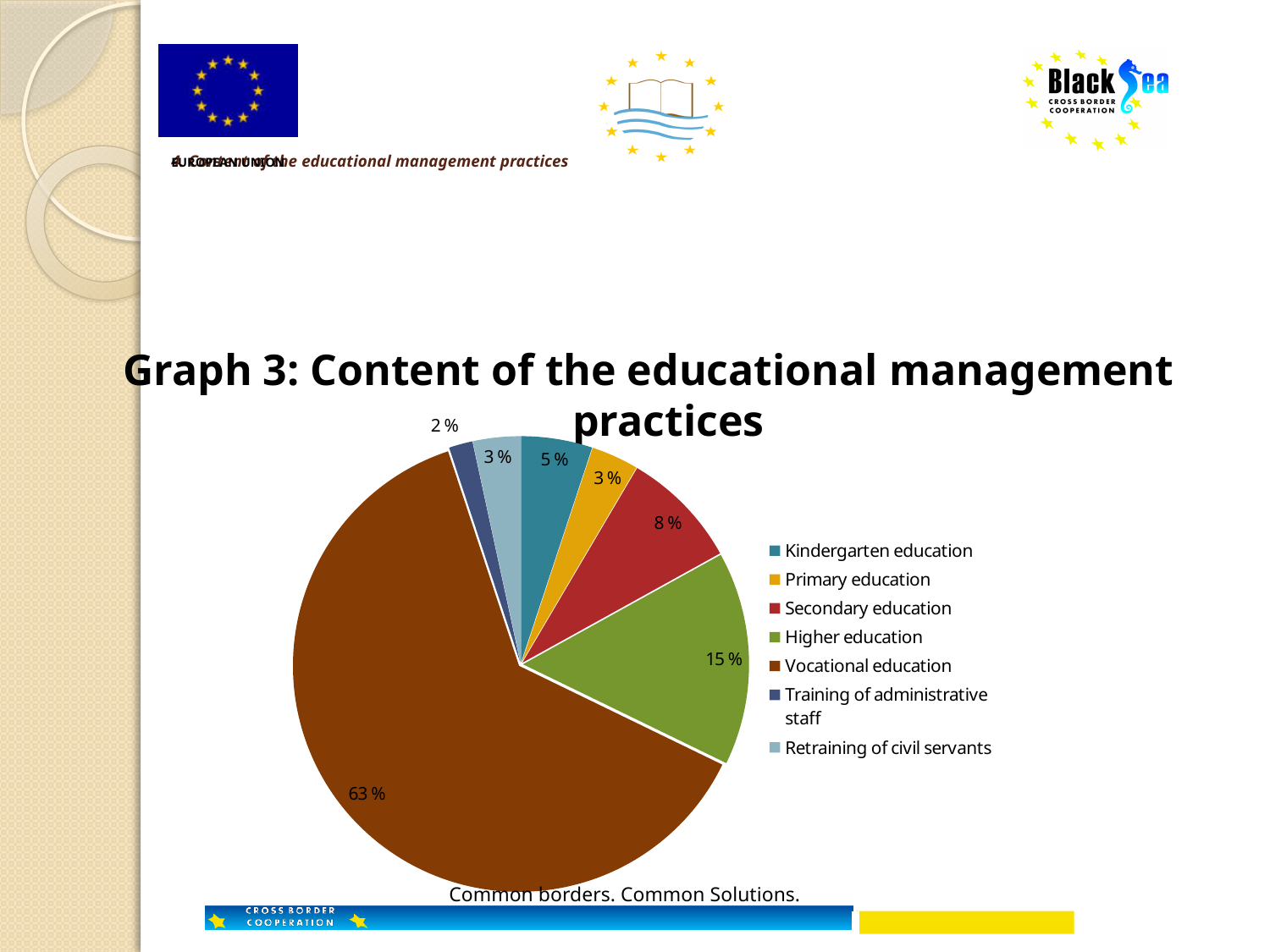
Which is larger, the share for Secondary education or the share for Kindergarten education? Secondary education What is the share for Training of administrative staff? 2 % What is the share for Kindergarten education? 5 % What is the difference between the shares for Vocational education and Higher education? 48 % How many categories does the legend list? 7 What is the share for Higher education? 15 % What is the share for Secondary education? 8 % Which category has the smallest share of the pie? Training of administrative staff Which category has the largest share of the pie? Vocational education What is the title of the chart? Graph 3: Content of the educational management practices What kind of chart is shown on the slide? pie chart What is the share for Vocational education? 63 %